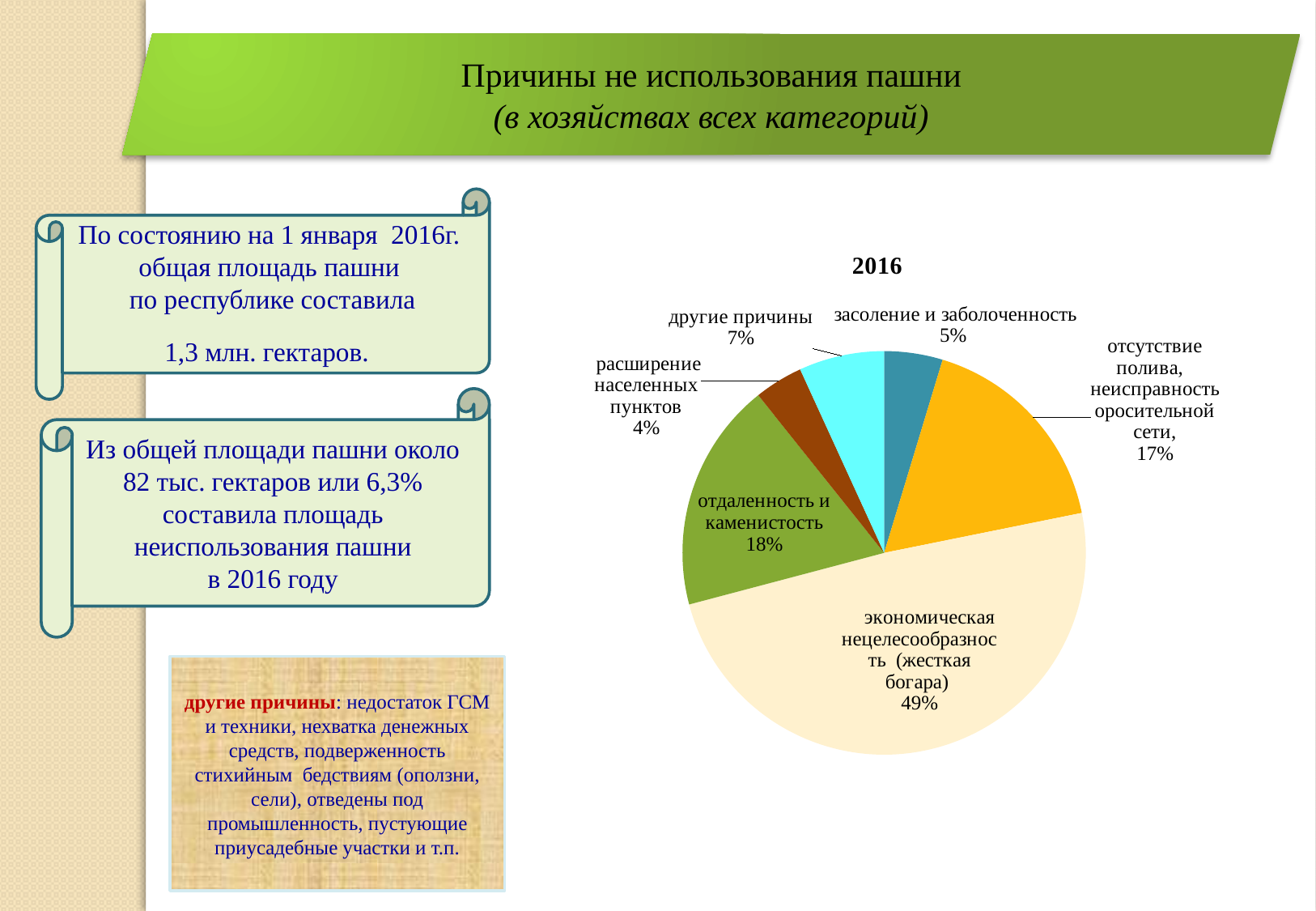
What is the difference in percentage points between "отдаленность и каменистость" and "другие причины"? 11% What share of the pie is labelled "экономическая нецелесообразность (жесткая богара)"? 49% What kind of chart is shown on the slide? Pie chart Which slice of the pie chart is the largest? экономическая нецелесообразность (жесткая богара) Which slice of the pie chart is the smallest? расширение населенных пунктов What share of the pie is labelled "другие причины"? 7% What share of the pie is labelled "отсутствие полива, неисправность оросительной сети"? 17% What is the title of the pie chart? 2016 How many slices does the pie chart have? 6